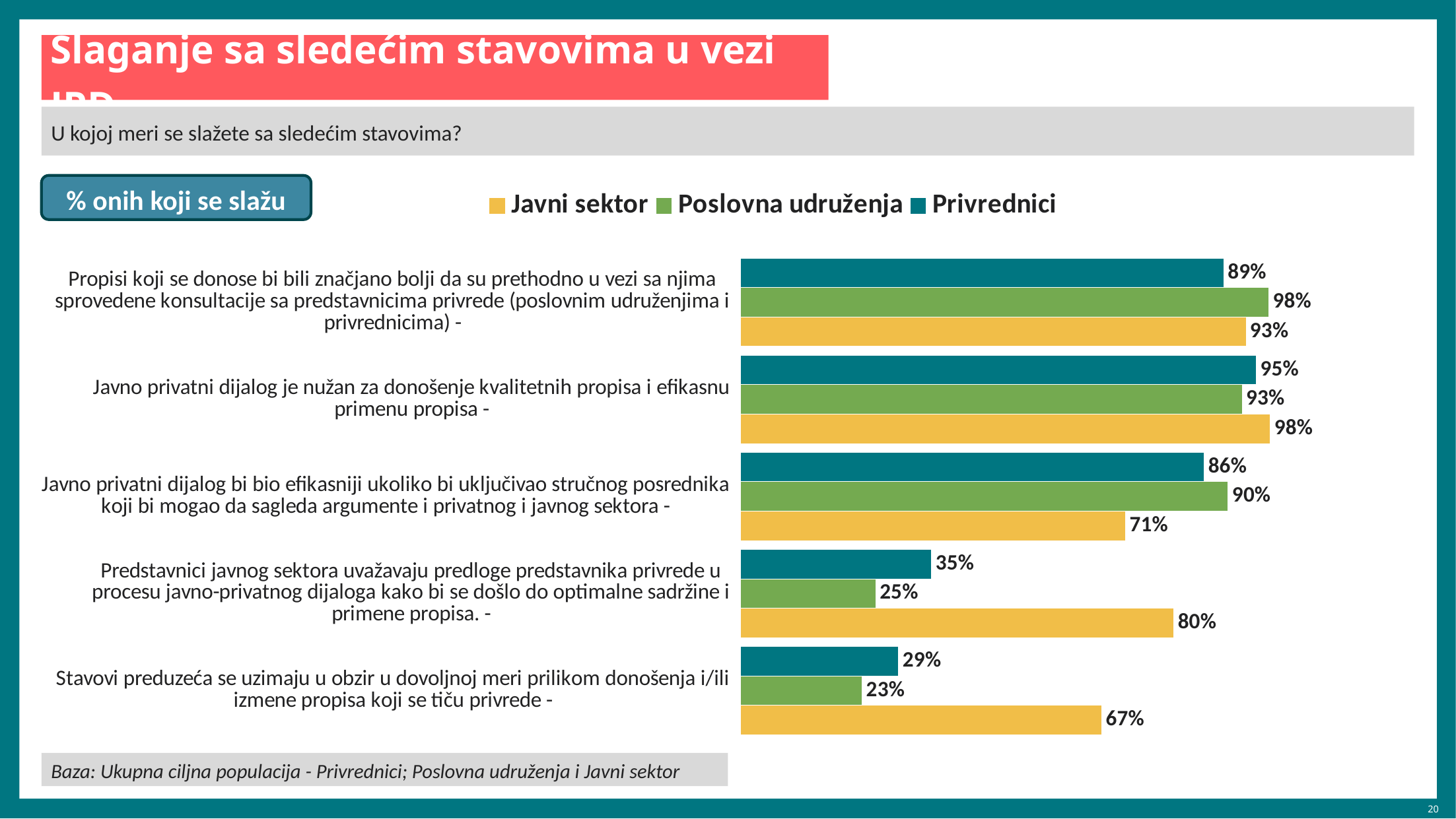
Which statement has the lowest value for Poslovna udruženja? Stavovi preduzeća se uzimaju u obzir u dovoljnoj meri prilikom donošenja i/ili izmene propisa koji se tiču privrede What is the difference between Javni sektor and Privrednici on the statement 'Predstavnici javnog sektora uvažavaju predloge predstavnika privrede...'? 45% How many series does the legend list? 3 What is the value for Poslovna udruženja on the statement 'Predstavnici javnog sektora uvažavaju predloge predstavnika privrede u procesu javno-privatnog dijaloga...'? 25% What is the value for Privrednici on the statement 'Javno privatni dijalog je nužan za donošenje kvalitetnih propisa i efikasnu primenu propisa'? 95% What kind of chart is shown on the slide? bar chart What is the difference between Poslovna udruženja and Privrednici on the statement 'Propisi koji se donose bi bili značjano bolji da su prethodno u vezi sa njima sprovedene konsultacije...'? 9% What is the value for Javni sektor on the statement 'Stavovi preduzeća se uzimaju u obzir u dovoljnoj meri prilikom donošenja i/ili izmene propisa koji se tiču privrede'? 67% Which colour represents the Privrednici series in the chart? teal Which statement has the highest value for Javni sektor? Javno privatni dijalog je nužan za donošenje kvalitetnih propisa i efikasnu primenu propisa How many statements (categories) are shown in the chart? 5 On the statement 'Javno privatni dijalog bi bio efikasniji ukoliko bi uključivao stručnog posrednika...', which is larger: Poslovna udruženja or Javni sektor? Poslovna udruženja